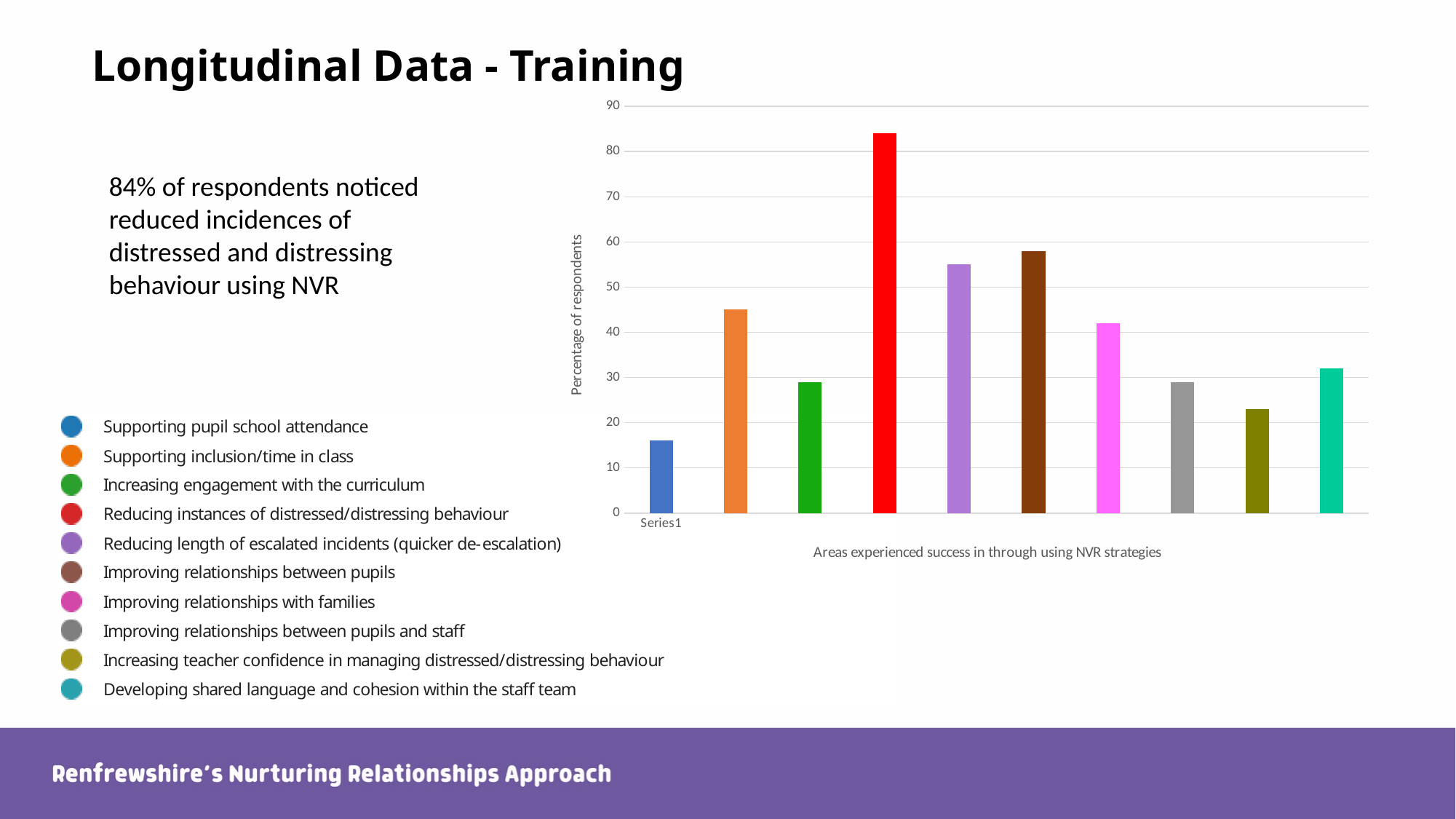
Is the value for Reducing length of escalated incidents (quicker de-escalation) greater or less than 50? greater What kind of chart is shown on the slide? bar chart Which category has the lowest percentage of respondents? Supporting pupil school attendance What is the label on the vertical axis of the chart? Percentage of respondents Which category has the highest percentage of respondents? Reducing instances of distressed/distressing behaviour What percentage of respondents noticed reduced incidences of distressed and distressing behaviour? 84% Is the value for Supporting pupil school attendance greater or less than 20? less How many categories (bars) are plotted in the chart? 10 What is the title shown beneath the horizontal axis of the chart? Areas experienced success in through using NVR strategies Which is larger: the value for Supporting inclusion/time in class or the value for Increasing engagement with the curriculum? Supporting inclusion/time in class Is the value for Improving relationships with families greater or less than 50? less